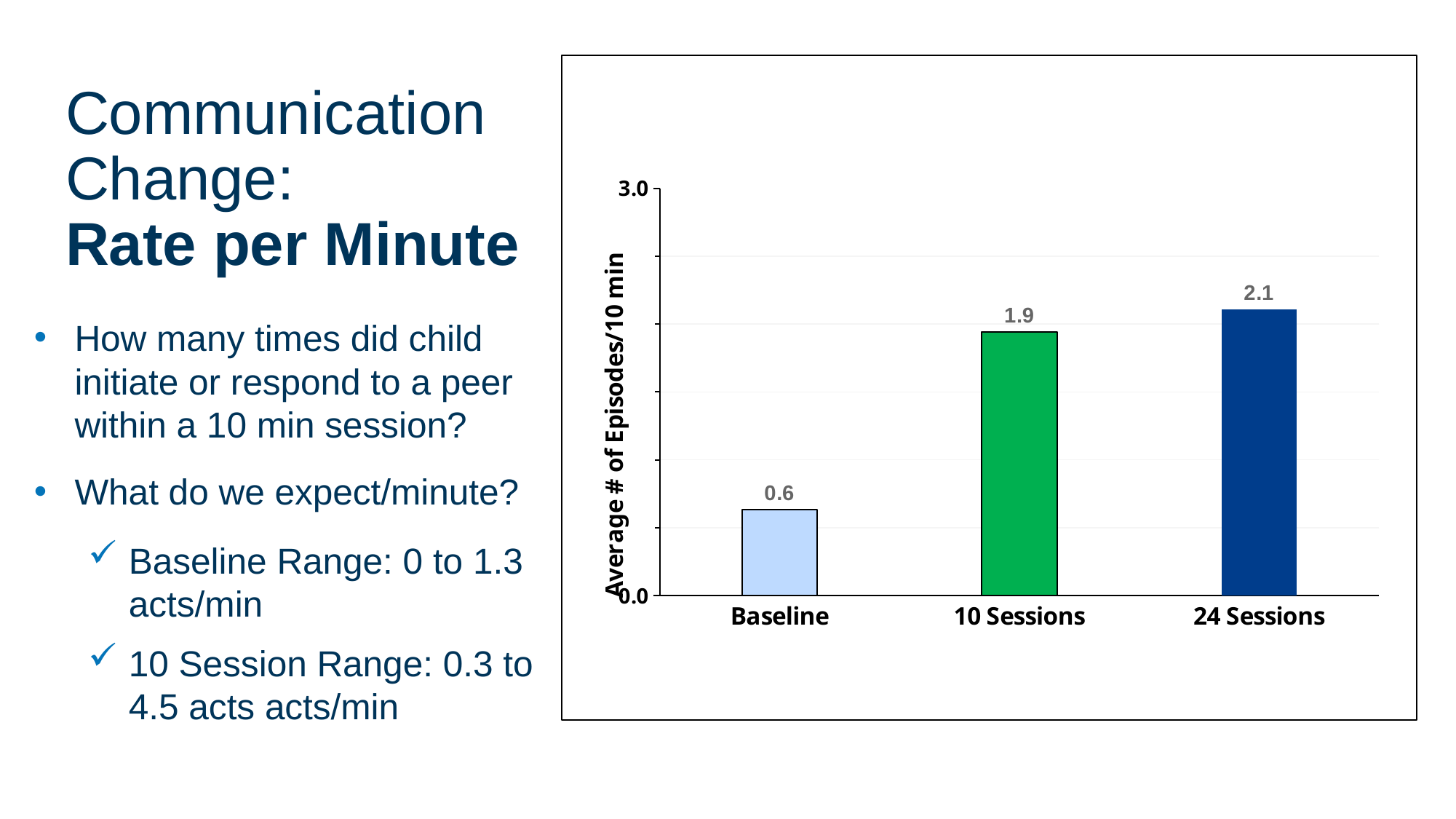
What kind of chart is shown on the slide? bar chart What is the average number of episodes per 10 min after 10 Sessions? 1.9 What is the difference between the 24 Sessions value and the Baseline value? 1.5 What is the average number of episodes per 10 min after 24 Sessions? 2.1 Do the values rise or fall from Baseline to 24 Sessions? rise Which category has the highest average number of episodes per 10 min? 24 Sessions How many categories are shown on the x axis of the chart? 3 Which is larger, the value for 10 Sessions or the value for Baseline? 10 Sessions What is the difference between the 10 Sessions value and the Baseline value? 1.3 Which category has the lowest average number of episodes per 10 min? Baseline Is the value for 24 Sessions greater or less than 3.0? less What is the average number of episodes per 10 min at Baseline? 0.6